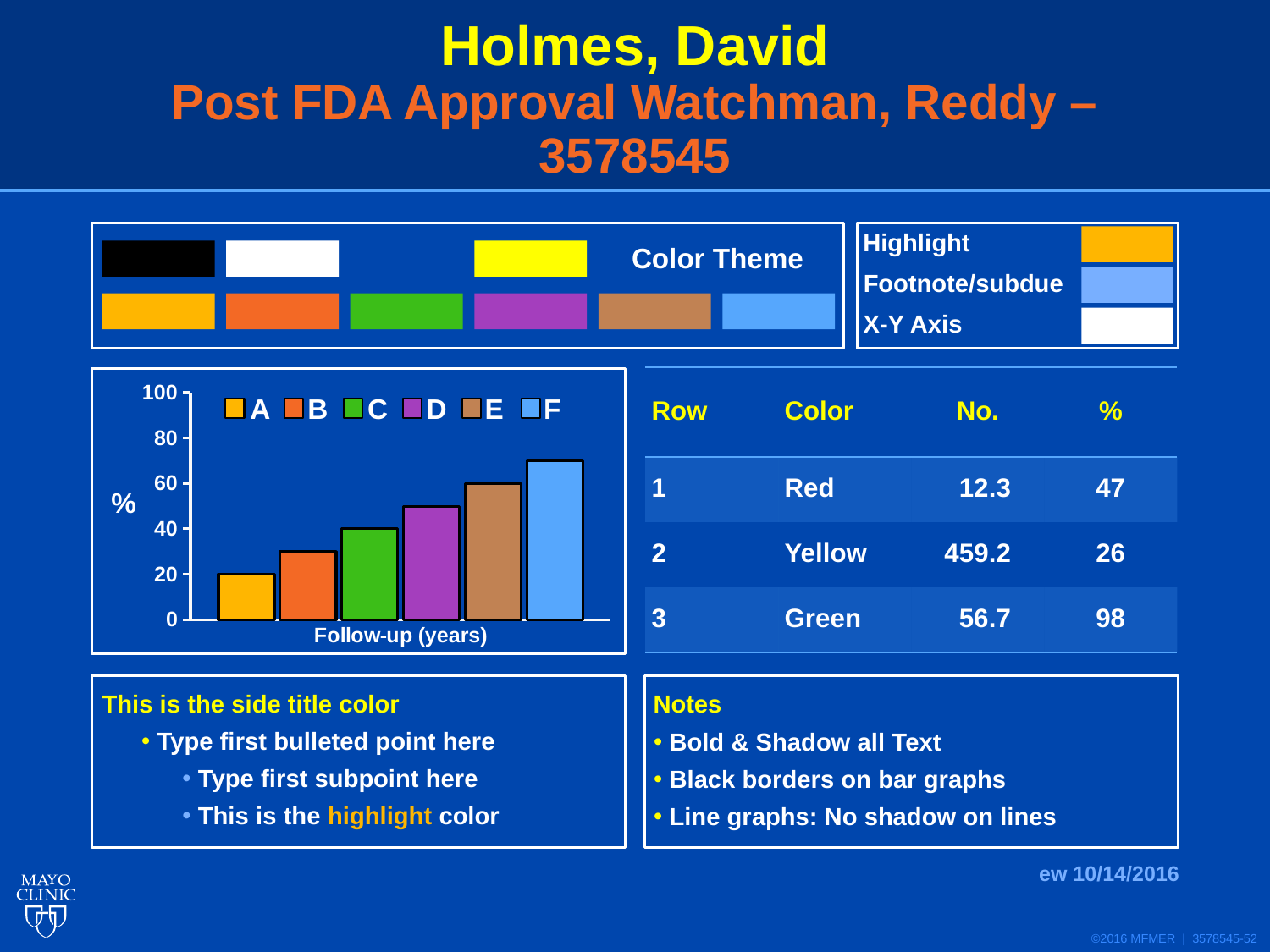
What is the value for series E in the chart? 60 How many series does the chart legend list? 6 Do the bar values rise or fall from series A to series F along the x axis? rise Which is larger, the value for series E or the value for series B? E Which series has the shortest bar in the chart? A What kind of chart is shown on the slide? bar chart Which series has the tallest bar in the chart? F Is the value for series F greater or less than 60? greater What is the value for series C in the chart? 40 What is the value for series A in the chart? 20 Is the value for series B greater or less than 40? less How many bars are plotted in the chart? 6